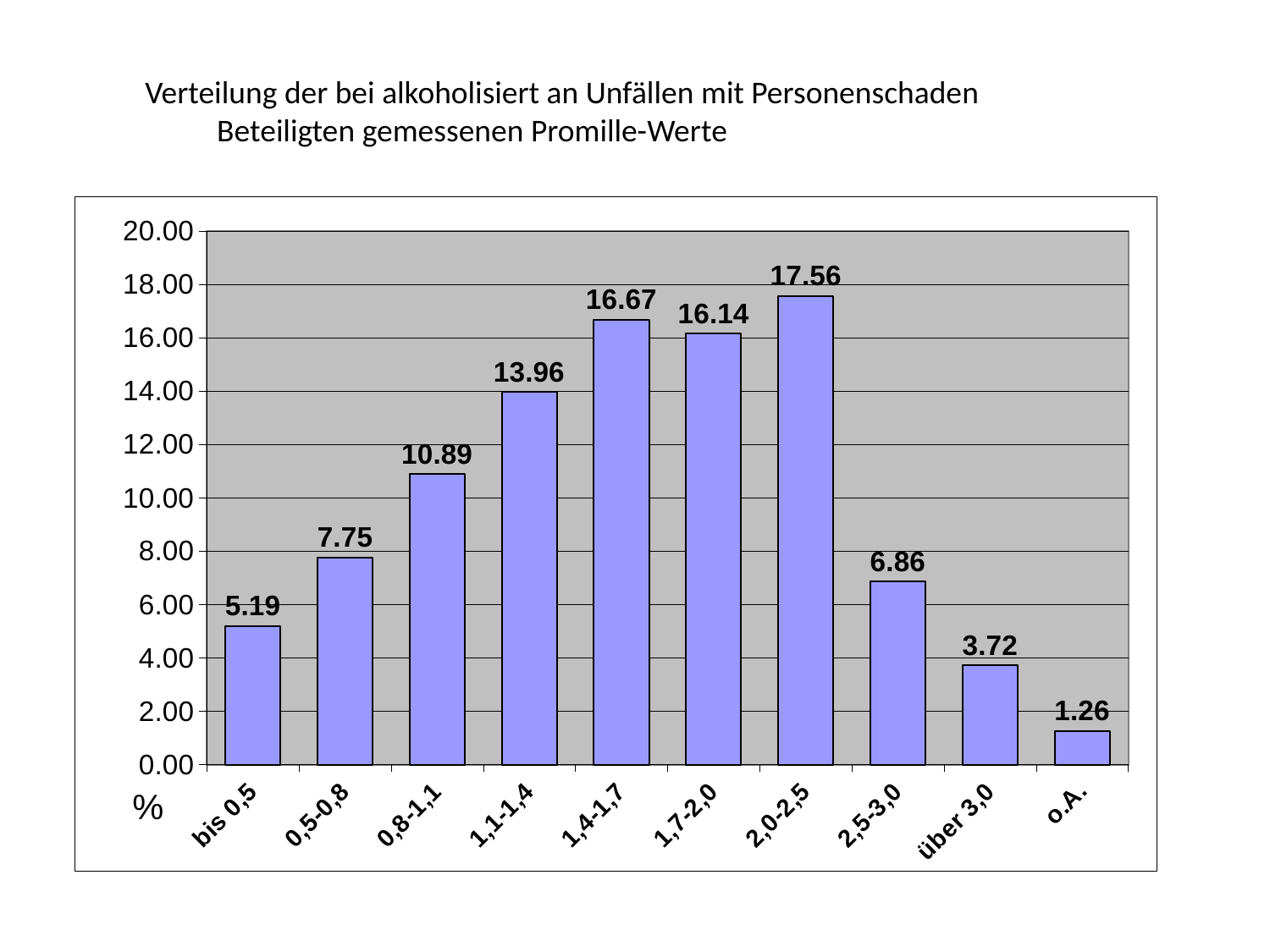
What is the value for the category bis 0,5? 5.19 What is the value for the category 1,4-1,7? 16.67 What unit label is shown at the bottom left of the y axis? % What kind of chart is shown on the slide? bar chart Which category has the highest value? 2,0-2,5 Do the values rise or fall from bis 0,5 to 1,4-1,7? rise Which is larger, the value for 0,8-1,1 or the value for 2,5-3,0? 0,8-1,1 Is the value for 1,1-1,4 greater or less than 12.00? greater What is the difference between the values for 2,0-2,5 and 1,7-2,0? 1.42 How many categories are shown on the x axis? 10 What is the value for the category o.A.? 1.26 Which category has the lowest value? o.A.